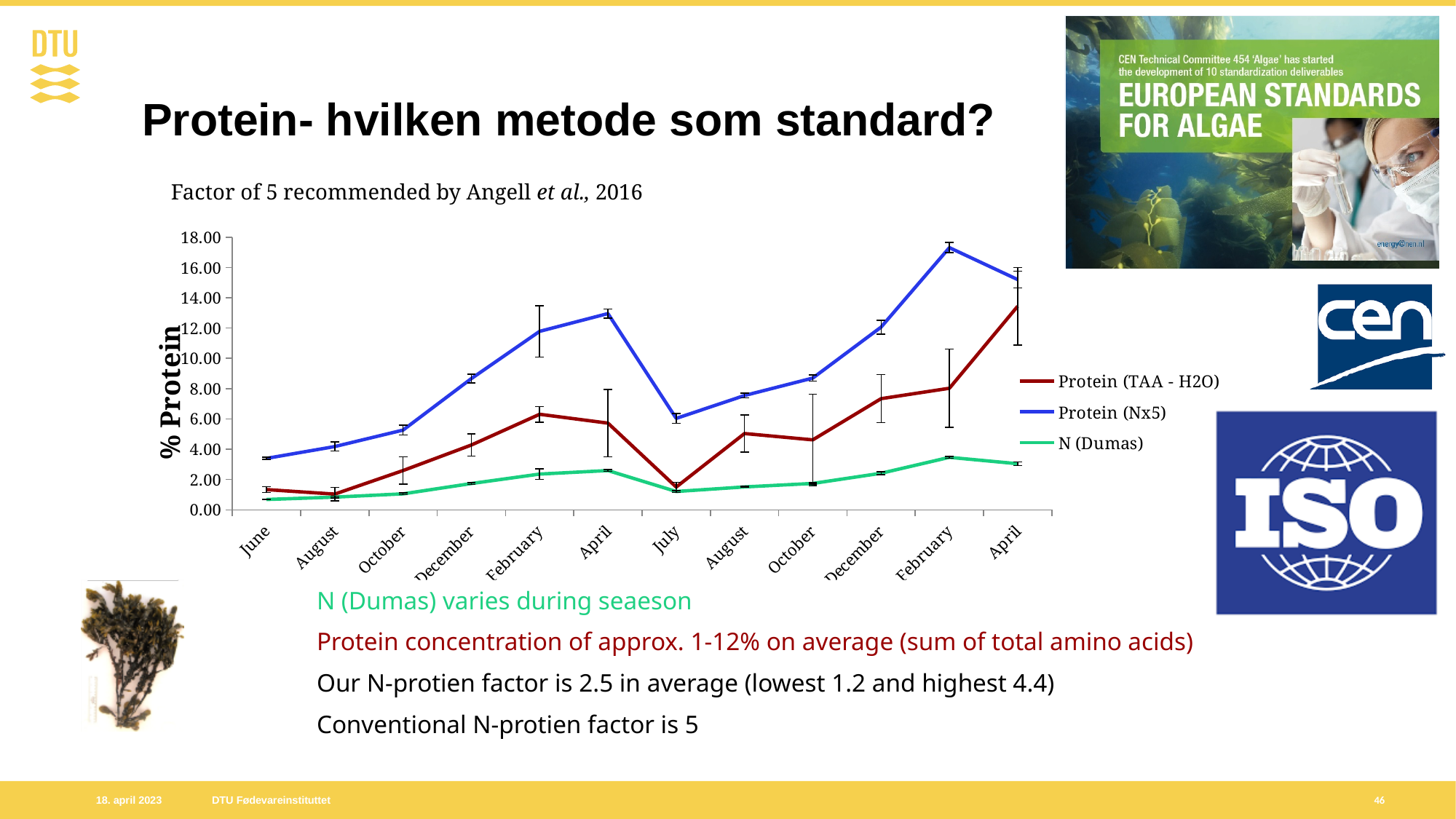
Does the Protein (Nx5) line rise or fall from the first April to July? fall At the first April, which is larger: Protein (Nx5) or Protein (TAA - H2O)? Protein (Nx5) Is the value for Protein (Nx5) at the first June greater or less than 6.00? less How many series does the chart legend list? 3 Is the value for Protein (Nx5) at the first April greater or less than 10.00? greater Is the value for N (Dumas) at July greater or less than 2.00? less Which series has the lowest values across the whole chart? N (Dumas) What kind of chart is shown on the slide? line chart How many points (months) are shown along the x axis of the chart? 12 What is the label on the y axis of the chart? % Protein Which series reaches the highest value on the chart? Protein (Nx5)